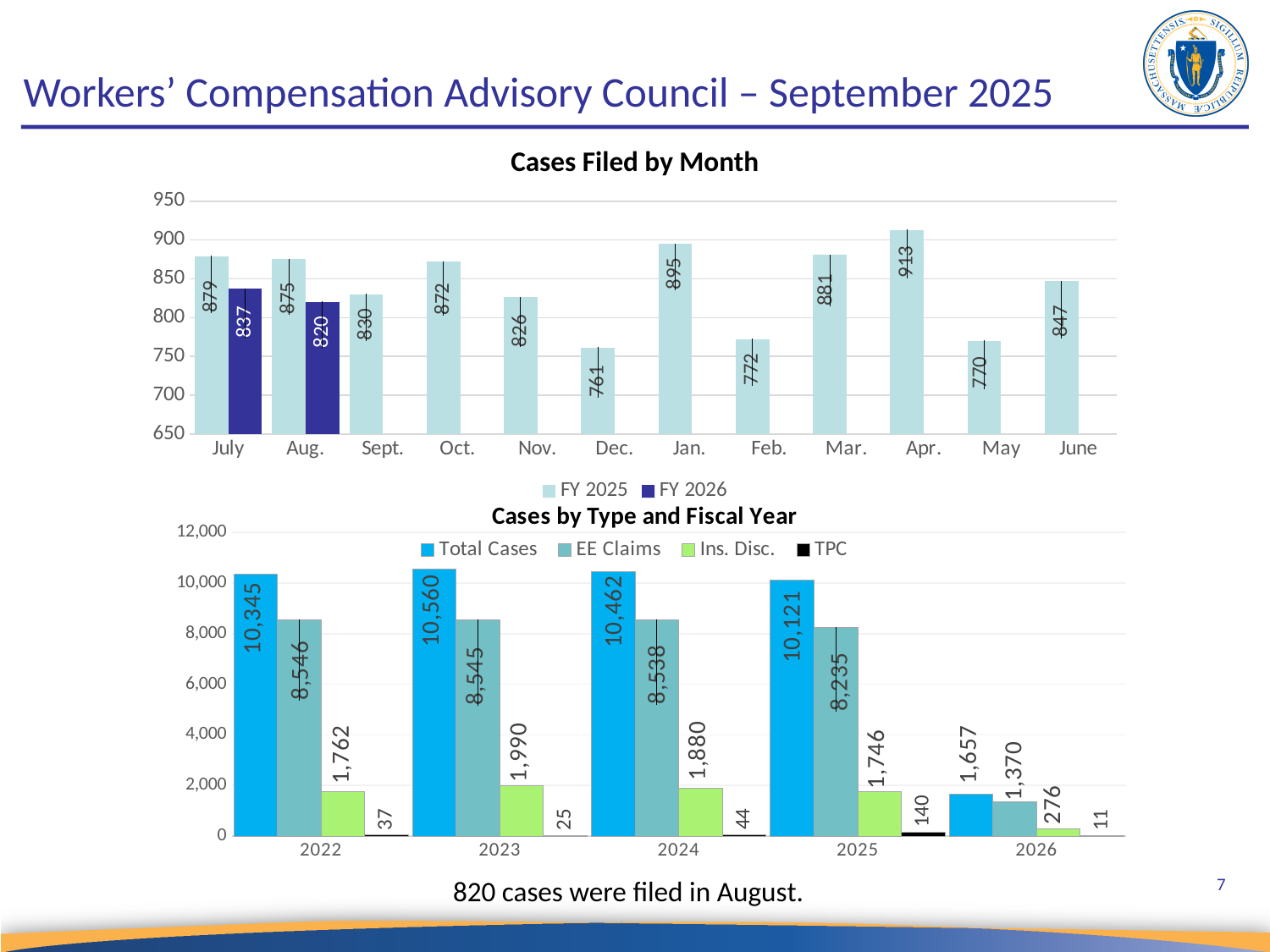
What kind of chart is 'Cases by Type and Fiscal Year'? Bar chart In the 'Cases Filed by Month' chart, is the FY 2025 value for January greater or less than 850? greater In the 'Cases by Type and Fiscal Year' chart, what is the Total Cases value for 2023? 10,560 In the 'Cases by Type and Fiscal Year' chart, what is the TPC value for 2025? 140 In the 'Cases by Type and Fiscal Year' chart, how many fiscal years are shown on the x axis? 5 In the 'Cases Filed by Month' chart, what is the FY 2026 value for August? 820 In the 'Cases Filed by Month' chart, what is the difference between the FY 2025 and FY 2026 values for July? 42 In the 'Cases Filed by Month' chart, what is the FY 2025 value for April? 913 In the 'Cases by Type and Fiscal Year' chart, which fiscal year has the highest Total Cases value? 2023 In the 'Cases by Type and Fiscal Year' chart, which is larger: EE Claims for 2022 or EE Claims for 2025? 2022 In the 'Cases Filed by Month' chart, how many series does the legend list? 2 In the 'Cases Filed by Month' chart, which month has the lowest FY 2025 value? Dec.